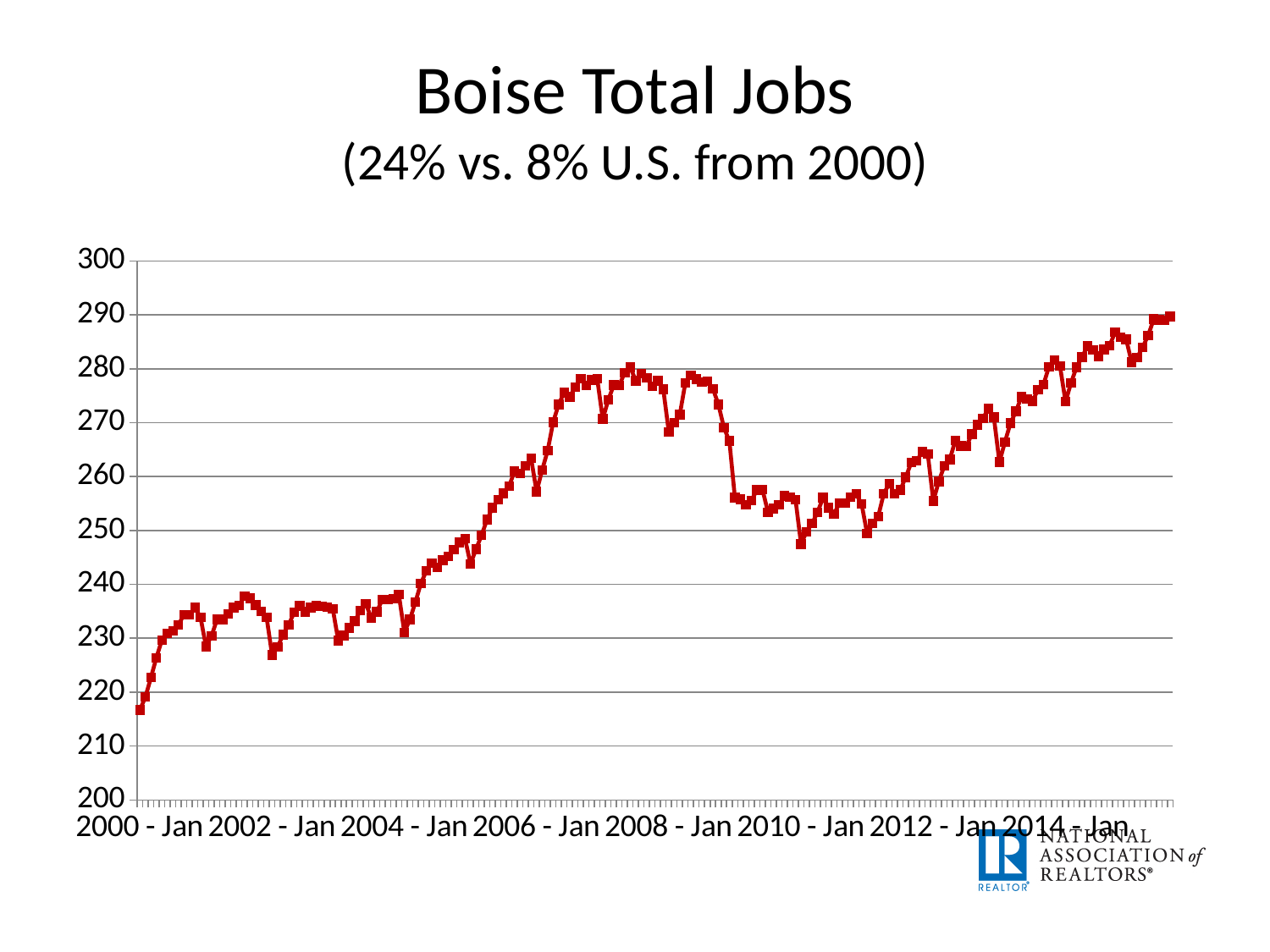
Is the value at 2000 - Jan greater or less than 220? less What is the title of the chart? Boise Total Jobs Is the value at 2010 - Jan greater or less than 260? less Is the value at 2014 - Jan greater or less than 280? less In which year does the line reach its lowest value? 2000 Which is larger, the value at 2008 - Jan or the value at 2010 - Jan? 2008 - Jan Overall, do the values rise or fall from 2000 - Jan to 2014 - Jan? rise What kind of chart is shown on the slide? line chart What comparison is given in the chart's subtitle? 24% vs. 8% U.S. from 2000